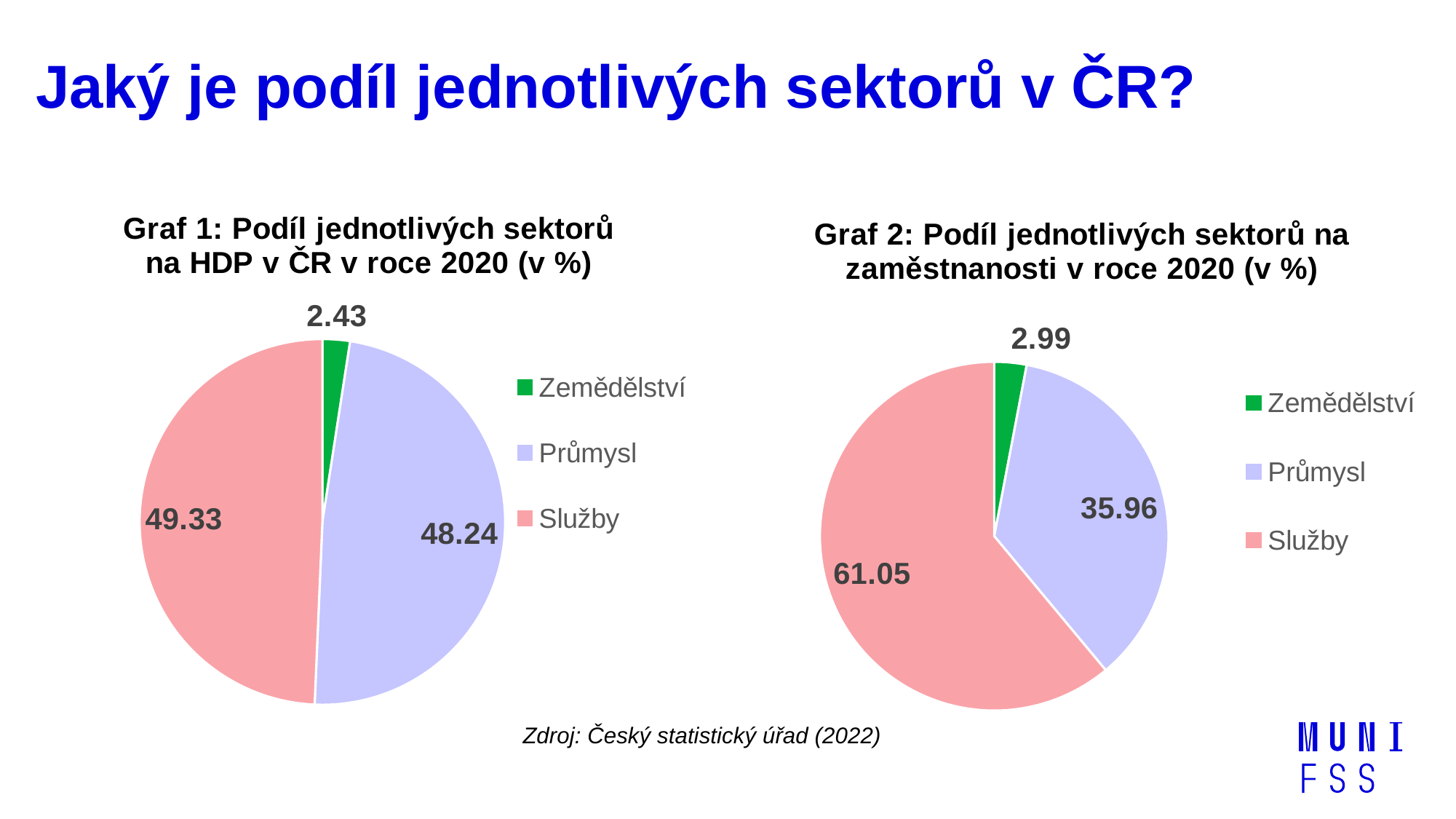
In Graf 2 (Podíl jednotlivých sektorů na zaměstnanosti v roce 2020), what is the value for Služby? 61.05 What kind of chart is Graf 1 (Podíl jednotlivých sektorů na HDP v ČR v roce 2020)? Pie chart In Graf 1 (Podíl jednotlivých sektorů na HDP v ČR v roce 2020), which sector has the smallest share? Zemědělství In Graf 2 (Podíl jednotlivých sektorů na zaměstnanosti v roce 2020), what is the difference between the values for Služby and Průmysl? 25.09 Which chart shows a larger value for Zemědělství, Graf 1 or Graf 2? Graf 2 In Graf 2 (Podíl jednotlivých sektorů na zaměstnanosti v roce 2020), which sector has the largest share? Služby In Graf 1 (Podíl jednotlivých sektorů na HDP v ČR v roce 2020), which colour represents Průmysl? Light purple (lavender) In Graf 2 (Podíl jednotlivých sektorů na zaměstnanosti v roce 2020), what is the value for Průmysl? 35.96 In Graf 1 (Podíl jednotlivých sektorů na HDP v ČR v roce 2020), what is the value for Zemědělství? 2.43 How many sectors are shown in Graf 2 (Podíl jednotlivých sektorů na zaměstnanosti v roce 2020)? 3 In Graf 1 (Podíl jednotlivých sektorů na HDP v ČR v roce 2020), what is the value for Průmysl? 48.24 In Graf 1 (Podíl jednotlivých sektorů na HDP v ČR v roce 2020), which is larger, the value for Služby or the value for Průmysl? Služby